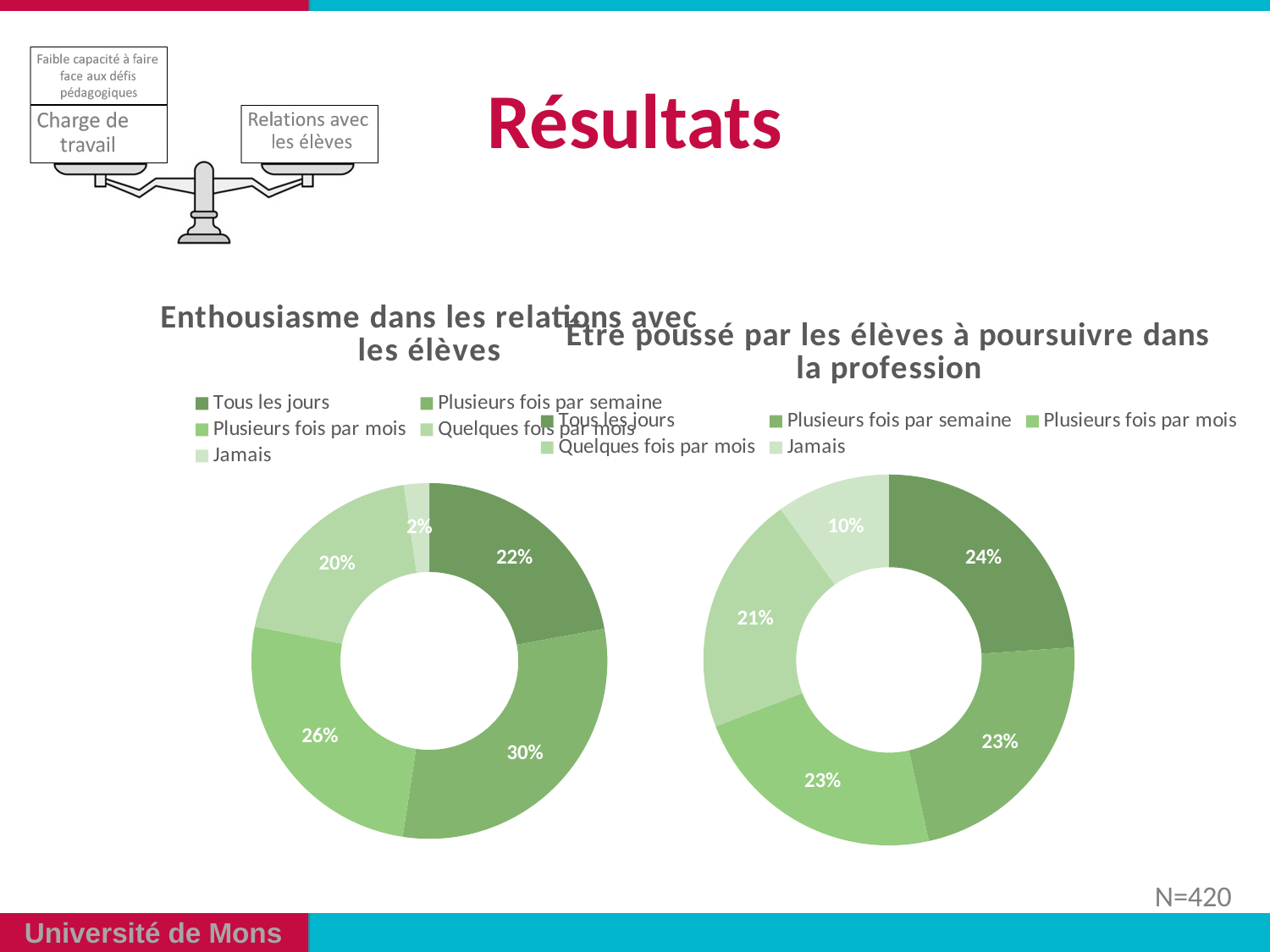
In the chart titled "Enthousiasme dans les relations avec les élèves", what is the difference between the shares for "Plusieurs fois par semaine" and "Plusieurs fois par mois"? 4% What kind of chart is the chart titled "Enthousiasme dans les relations avec les élèves"? Doughnut chart Which is larger in the chart titled "Enthousiasme dans les relations avec les élèves": the share for "Tous les jours" or the share for "Quelques fois par mois"? Tous les jours In the chart titled "Enthousiasme dans les relations avec les élèves", which category has the smallest share? Jamais In the chart titled "Etre poussé par les élèves à poursuivre dans la profession", which category has the smallest share? Jamais In the chart titled "Enthousiasme dans les relations avec les élèves", what percentage is shown for "Plusieurs fois par semaine"? 30% In the chart titled "Etre poussé par les élèves à poursuivre dans la profession", what percentage is shown for "Jamais"? 10% In the chart titled "Etre poussé par les élèves à poursuivre dans la profession", what is the difference between the shares for "Tous les jours" and "Jamais"? 14% In the chart titled "Etre poussé par les élèves à poursuivre dans la profession", what percentage is shown for "Tous les jours"? 24% In the chart titled "Enthousiasme dans les relations avec les élèves", what percentage is shown for "Jamais"? 2% In the chart titled "Enthousiasme dans les relations avec les élèves", which category has the largest share? Plusieurs fois par semaine How many categories does the legend of the chart titled "Etre poussé par les élèves à poursuivre dans la profession" list? 5